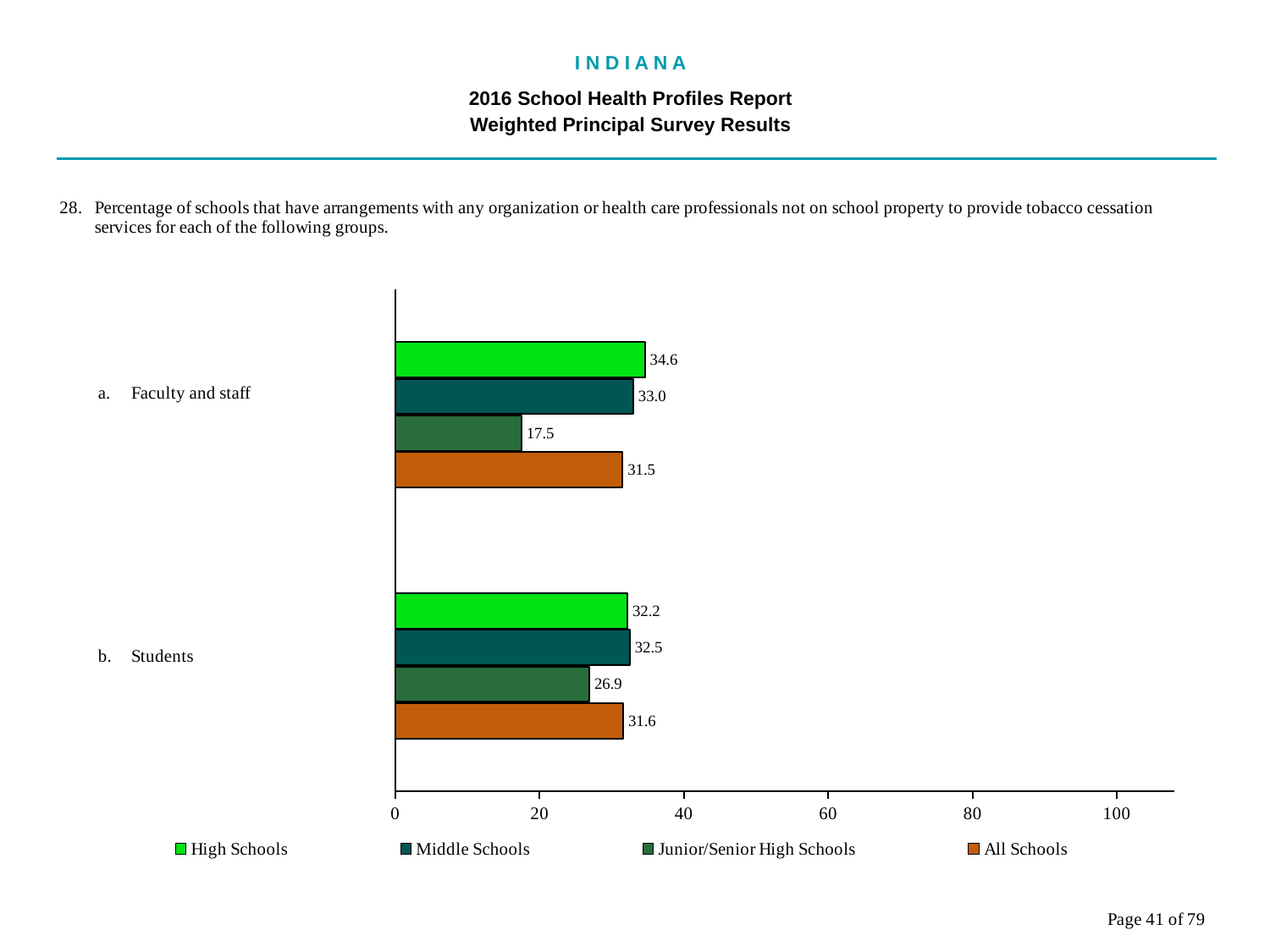
How many categories are shown on the chart? 2 Which series has the lowest value in the Faculty and staff category? Junior/Senior High Schools How many series does the legend list? 4 What is the value for Junior/Senior High Schools in the Students category? 26.9 Which series has the highest value in the Faculty and staff category? High Schools What is the value for High Schools in the Faculty and staff category? 34.6 What is the value for All Schools in the Faculty and staff category? 31.5 What is the difference between the Middle Schools and Junior/Senior High Schools values in the Students category? 5.6 Which is larger: the Junior/Senior High Schools value for Faculty and staff or for Students? Students What is the value for Middle Schools in the Students category? 32.5 What kind of chart is shown on the slide? Bar chart What is the difference between the High Schools and Junior/Senior High Schools values in the Faculty and staff category? 17.1